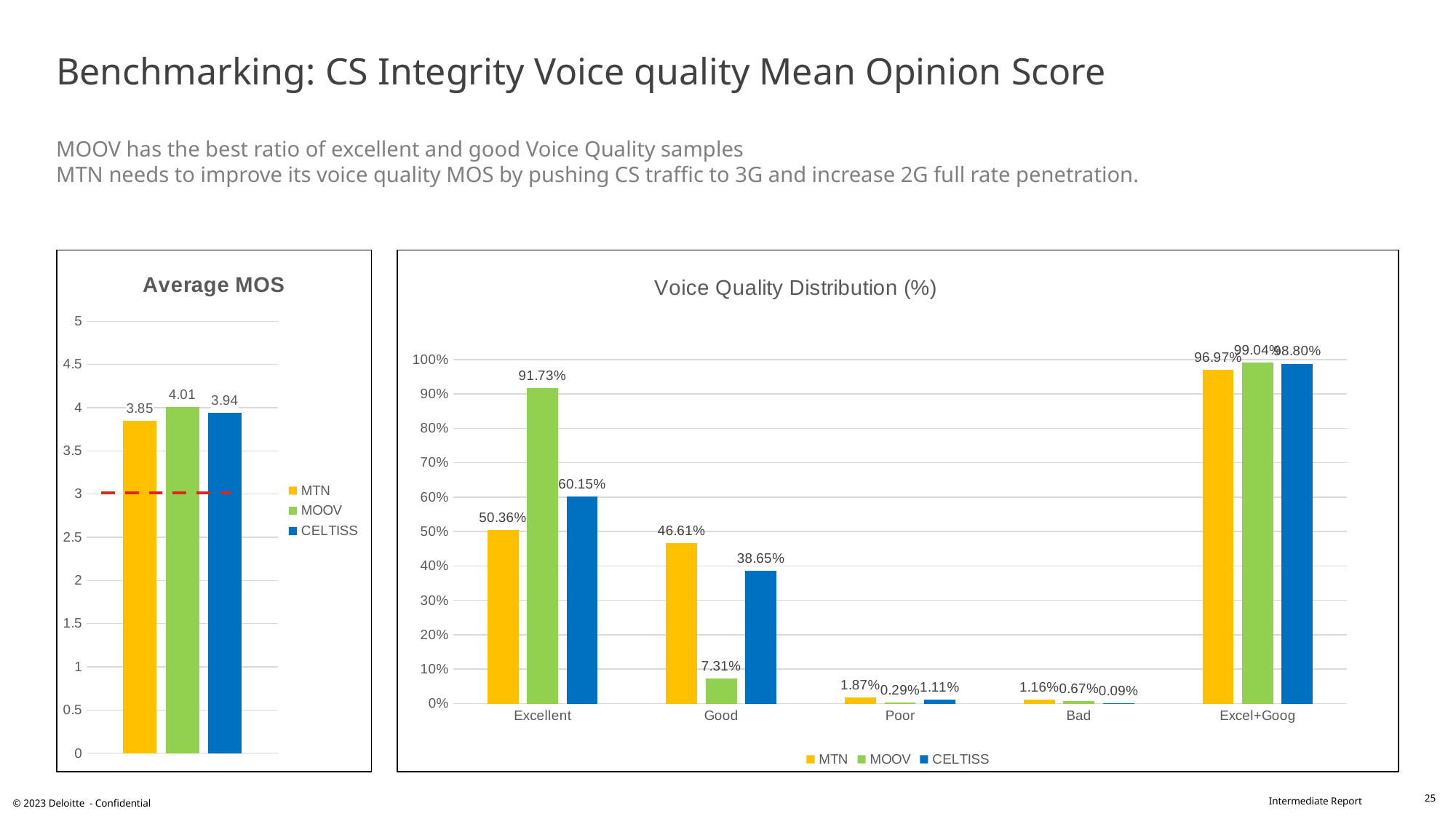
In the Average MOS chart, what is the difference between MOOV's and MTN's values? 0.16 In the Voice Quality Distribution (%) chart, which operator has the highest value for Excel+Goog? MOOV In the Average MOS chart, which operator has the lowest average MOS? MTN In the Average MOS chart, what is the value for MOOV? 4.01 In the Voice Quality Distribution (%) chart, what is the MOOV value for Excellent? 91.73% What kind of chart is the Voice Quality Distribution (%) chart? Bar chart In the Voice Quality Distribution (%) chart, how many categories are shown on the x axis? 5 In the Voice Quality Distribution (%) chart, what is the MTN value for Bad? 1.16% In the Voice Quality Distribution (%) chart, what is the CELTISS value for Good? 38.65% In the Voice Quality Distribution (%) chart, which is larger for Good: MTN or MOOV? MTN In the Average MOS chart, how many series does the legend list? 3 In the Voice Quality Distribution (%) chart, what is the difference between the MTN and CELTISS values for Excellent? 9.79%